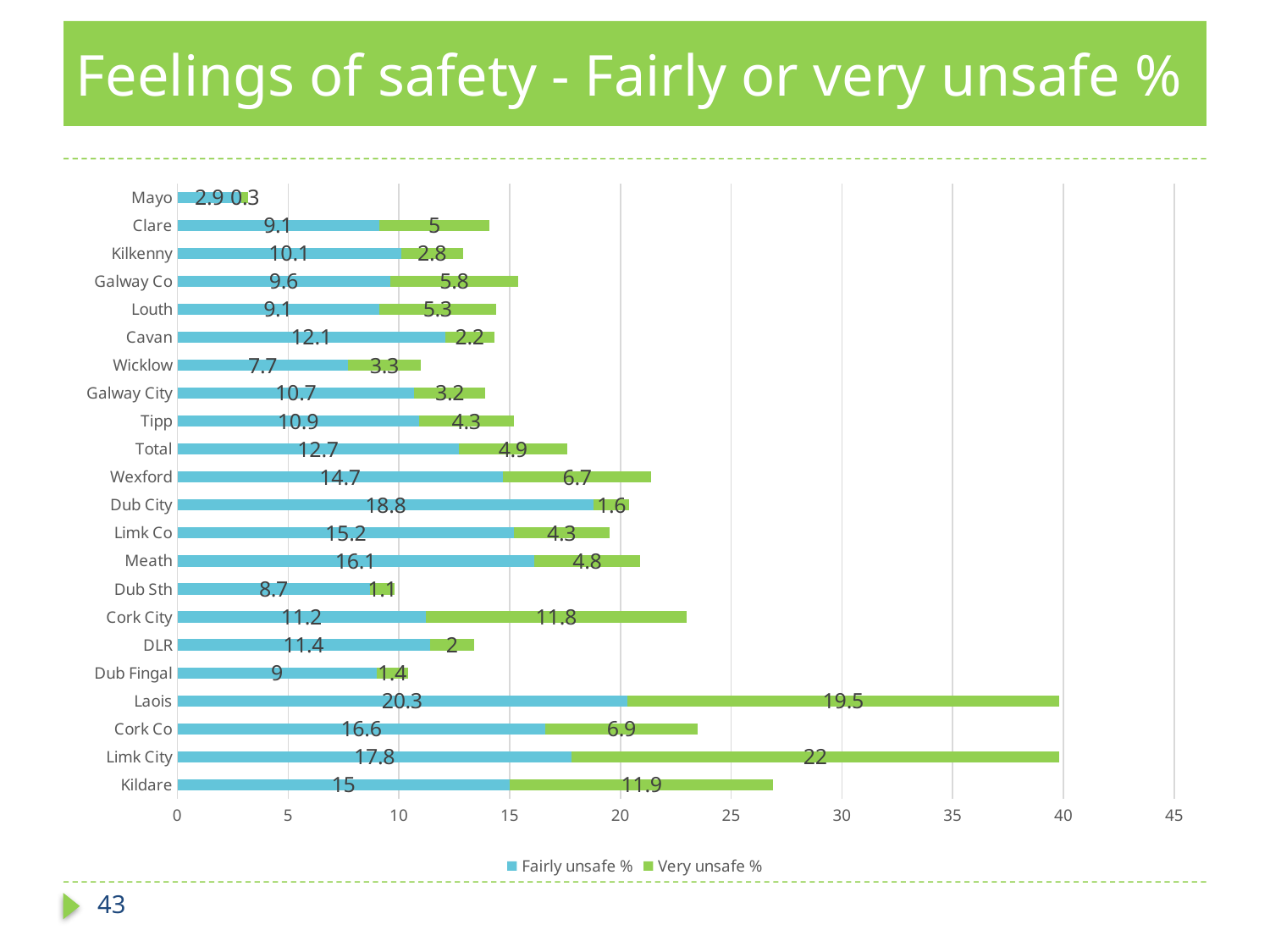
Which is larger, the Fairly unsafe % value for Wexford or for Meath? Meath What is the difference between the Fairly unsafe % values for Dub City and Dub Sth? 10.1 How many series does the legend list? 2 What is the Fairly unsafe % value for Laois? 20.3 What is the total of the stacked bar for Kildare? 26.9 What kind of chart is shown on the slide? Stacked bar chart What is the Very unsafe % value for Cork City? 11.8 Which category has the highest Very unsafe % value? Limk City How many categories are shown on the chart? 22 What is the title of the chart? Feelings of safety - Fairly or very unsafe % Which category has the lowest Fairly unsafe % value? Mayo What is the Very unsafe % value for Limk City? 22